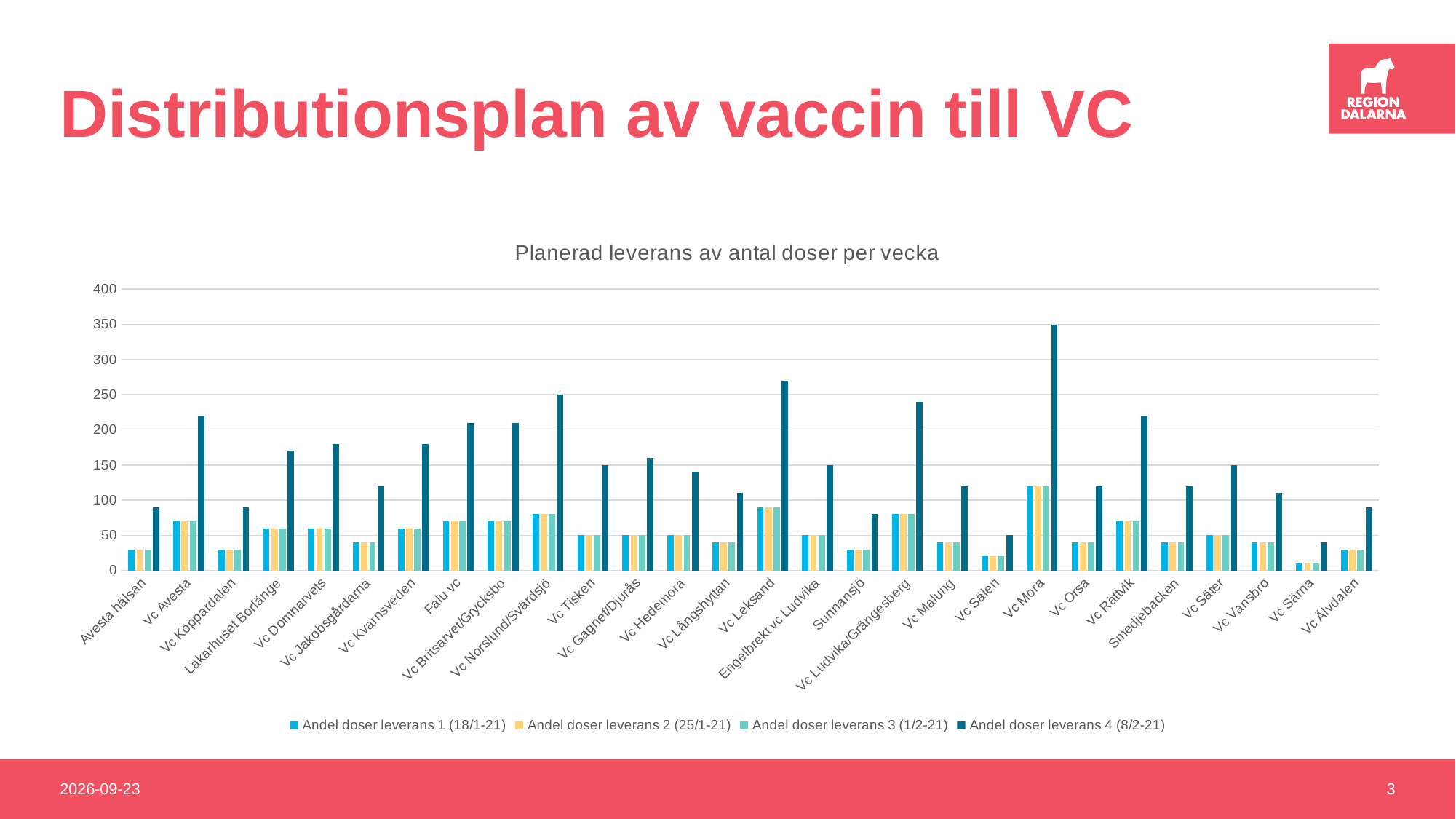
What is the title of the chart? Planerad leverans av antal doser per vecka Which vårdcentral has the highest value for Andel doser leverans 1 (18/1-21)? Vc Mora What is the value for Vc Norslund/Svärdsjö in Andel doser leverans 4 (8/2-21)? 250 What is the value for Vc Mora in Andel doser leverans 4 (8/2-21)? 350 How many vårdcentraler (categories) are shown on the x axis? 28 Which is larger for Andel doser leverans 4 (8/2-21): Vc Avesta or Vc Koppardalen? Vc Avesta How many series does the legend list? 4 Is the value for Vc Leksand in Andel doser leverans 4 (8/2-21) greater or less than 250? greater Which vårdcentral has the highest value for Andel doser leverans 4 (8/2-21)? Vc Mora What kind of chart is shown on the slide? Bar chart Is the value for Vc Särna in Andel doser leverans 4 (8/2-21) greater or less than 50? less Which vårdcentral has the lowest value for Andel doser leverans 4 (8/2-21)? Vc Särna